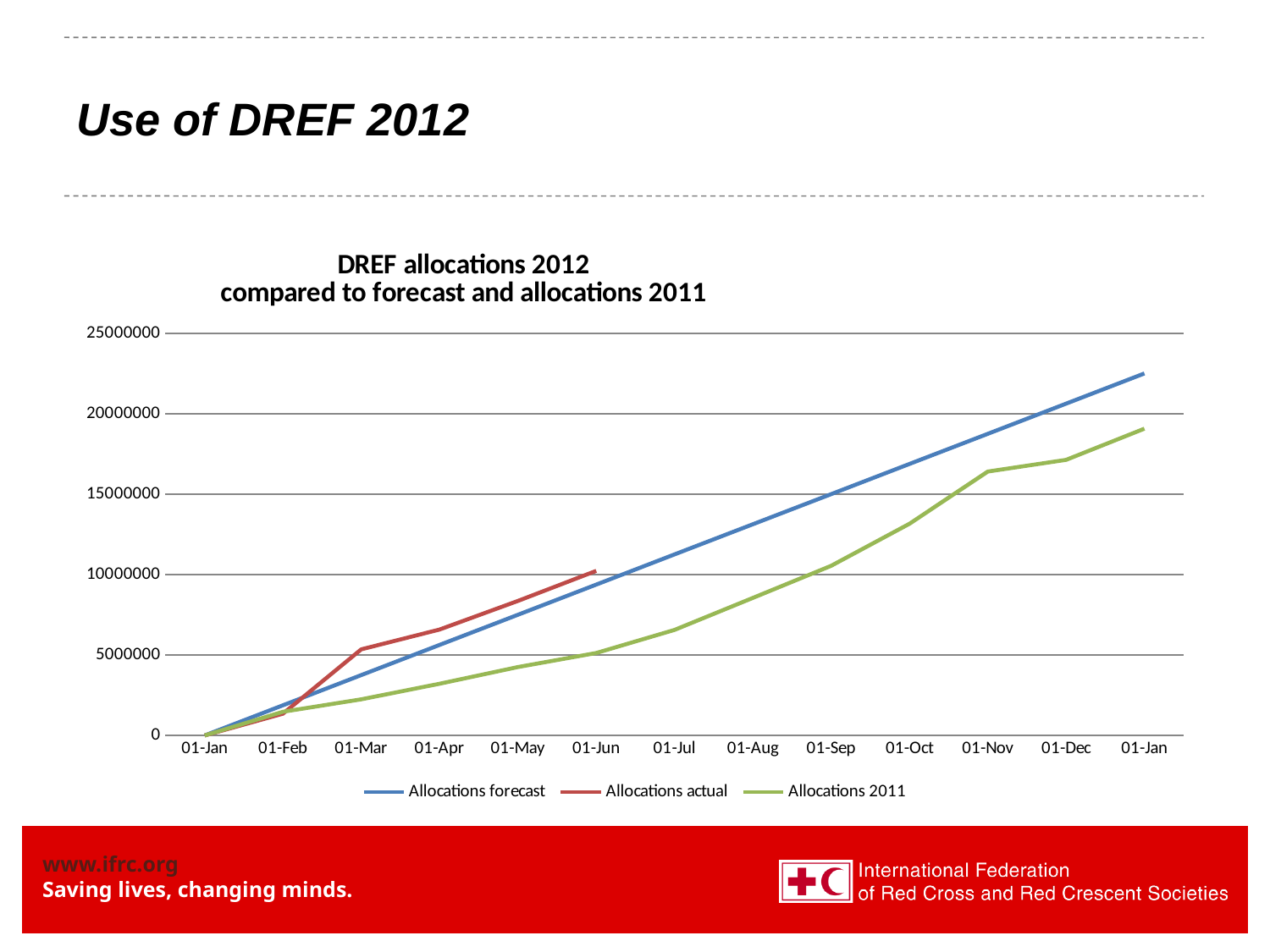
Is the value for Allocations 2011 at 01-Nov greater or less than 15000000? greater Which series in the chart stops at 01-Jun? Allocations actual Does the Allocations forecast line rise or fall from 01-Jan to the final 01-Jan? rise At 01-Mar, which is larger: Allocations actual or Allocations forecast? Allocations actual Is the value for Allocations 2011 at 01-Jul greater or less than 5000000? greater At 01-Nov, which is larger: Allocations forecast or Allocations 2011? Allocations forecast What kind of chart is shown on the slide? line chart How many date labels are shown along the x axis of the chart? 13 Is the value for Allocations forecast at the final 01-Jan greater or less than 20000000? greater What is the title of the chart? DREF allocations 2012 compared to forecast and allocations 2011 How many series does the chart legend list? 3